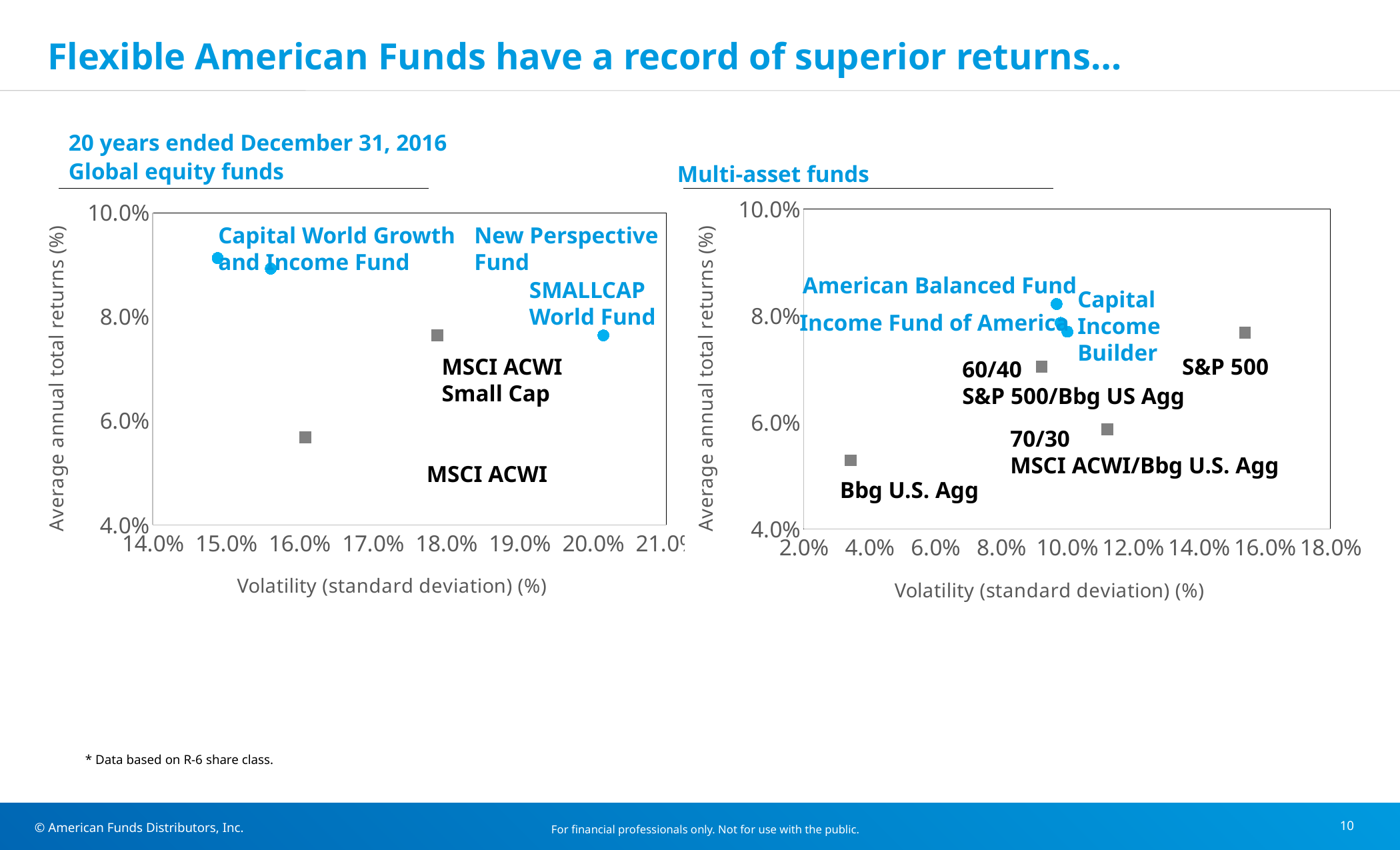
How many points are plotted on the Multi-asset funds chart? 7 What is the x-axis label on the Global equity funds chart? Volatility (standard deviation) (%) On the Multi-asset funds chart, is the volatility for Bbg U.S. Agg greater or less than 4.0%? less On the Multi-asset funds chart, which point has the highest average annual total return? American Balanced Fund On the Global equity funds chart, is the average annual total return for Capital World Growth and Income Fund greater or less than 8.0%? greater On the Multi-asset funds chart, which point has the lowest average annual total return? Bbg U.S. Agg On the Multi-asset funds chart, which has the higher volatility, S&P 500 or 70/30 MSCI ACWI/Bbg U.S. Agg? S&P 500 On the Global equity funds chart, is the average annual total return for MSCI ACWI greater or less than 6.0%? less On the Global equity funds chart, which point has the lowest average annual total return? MSCI ACWI What kind of chart is the Global equity funds chart? scatter chart How many points are plotted on the Global equity funds chart? 5 On the Global equity funds chart, which has the higher average annual total return, New Perspective Fund or MSCI ACWI? New Perspective Fund